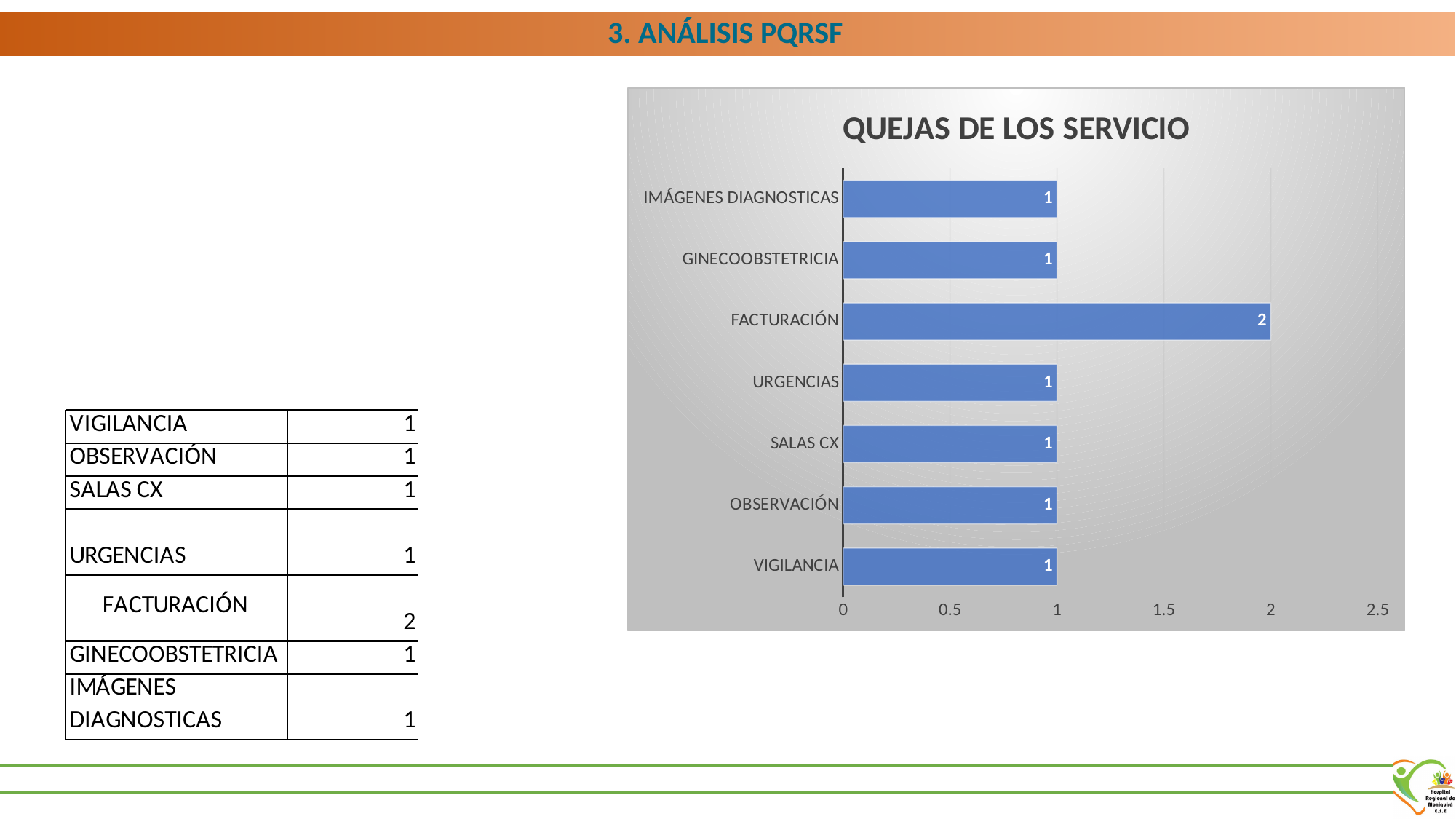
What kind of chart is shown on the slide? Bar chart What is the value for IMÁGENES DIAGNOSTICAS in the chart? 1 How many categories in the chart have a value of 1? 6 Which category has the highest value in the chart? FACTURACIÓN What is the title of the chart? QUEJAS DE LOS SERVICIO Which is larger, the value for FACTURACIÓN or the value for SALAS CX? FACTURACIÓN What is the value for URGENCIAS in the chart? 1 What is the maximum value shown on the horizontal axis of the chart? 2.5 What is the value for FACTURACIÓN in the chart? 2 What is the difference between the values for FACTURACIÓN and VIGILANCIA? 1 How many categories are shown in the chart? 7 Is the value for FACTURACIÓN greater or less than 1.5? greater